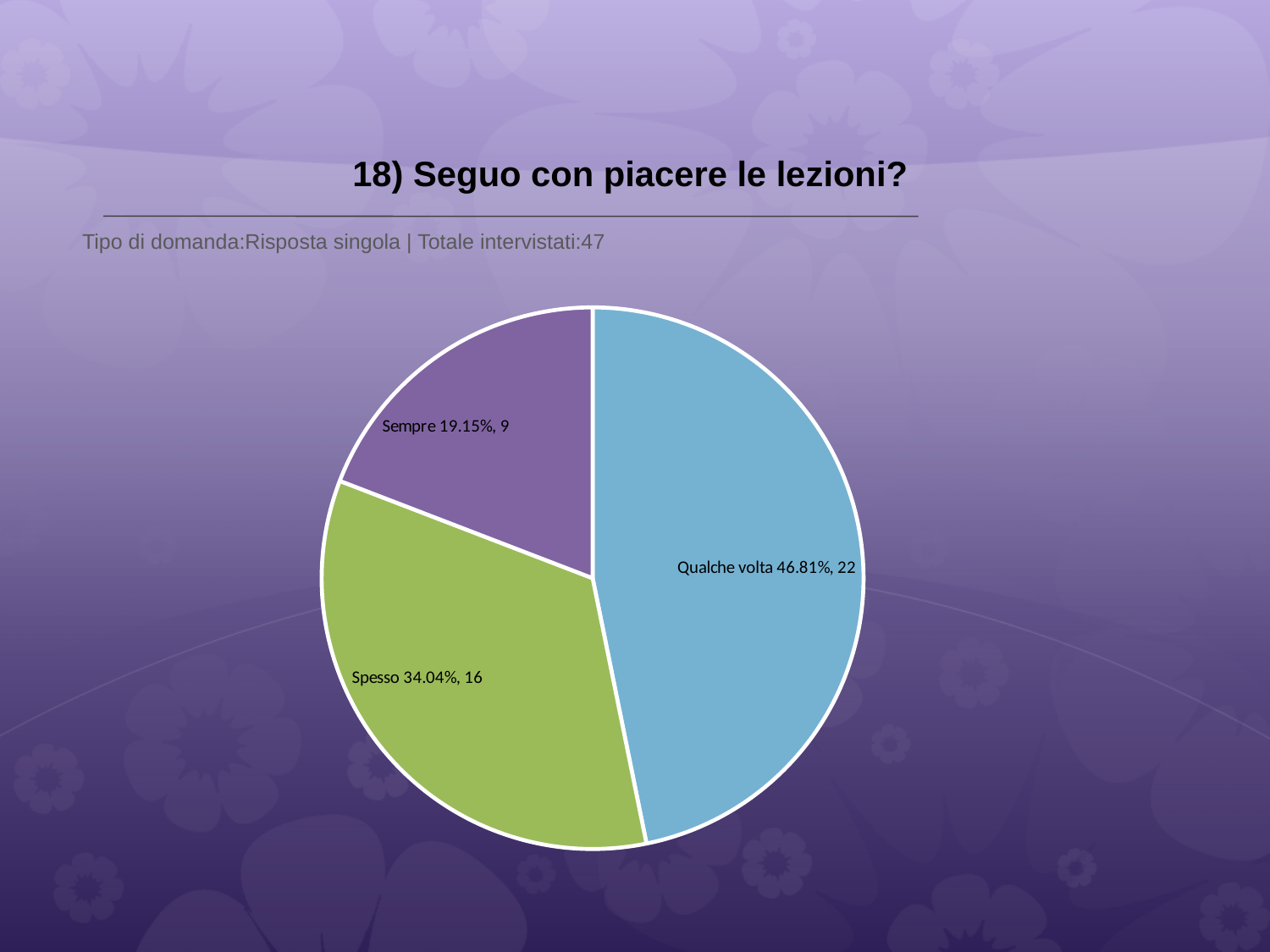
Which category has the smallest slice? Sempre What is the difference in respondent count between 'Qualche volta' and 'Sempre'? 13 What percentage share does the 'Spesso' slice have? 34.04% What percentage share does the 'Qualche volta' slice have? 46.81% What kind of chart is shown on the slide? pie chart What is the title of the chart on the slide? 18) Seguo con piacere le lezioni? What percentage share does the 'Sempre' slice have? 19.15% Which category has the largest slice? Qualche volta How many respondents answered 'Spesso'? 16 How many respondents answered 'Qualche volta'? 22 How many respondents answered 'Sempre'? 9 How many slices does the pie chart have? 3